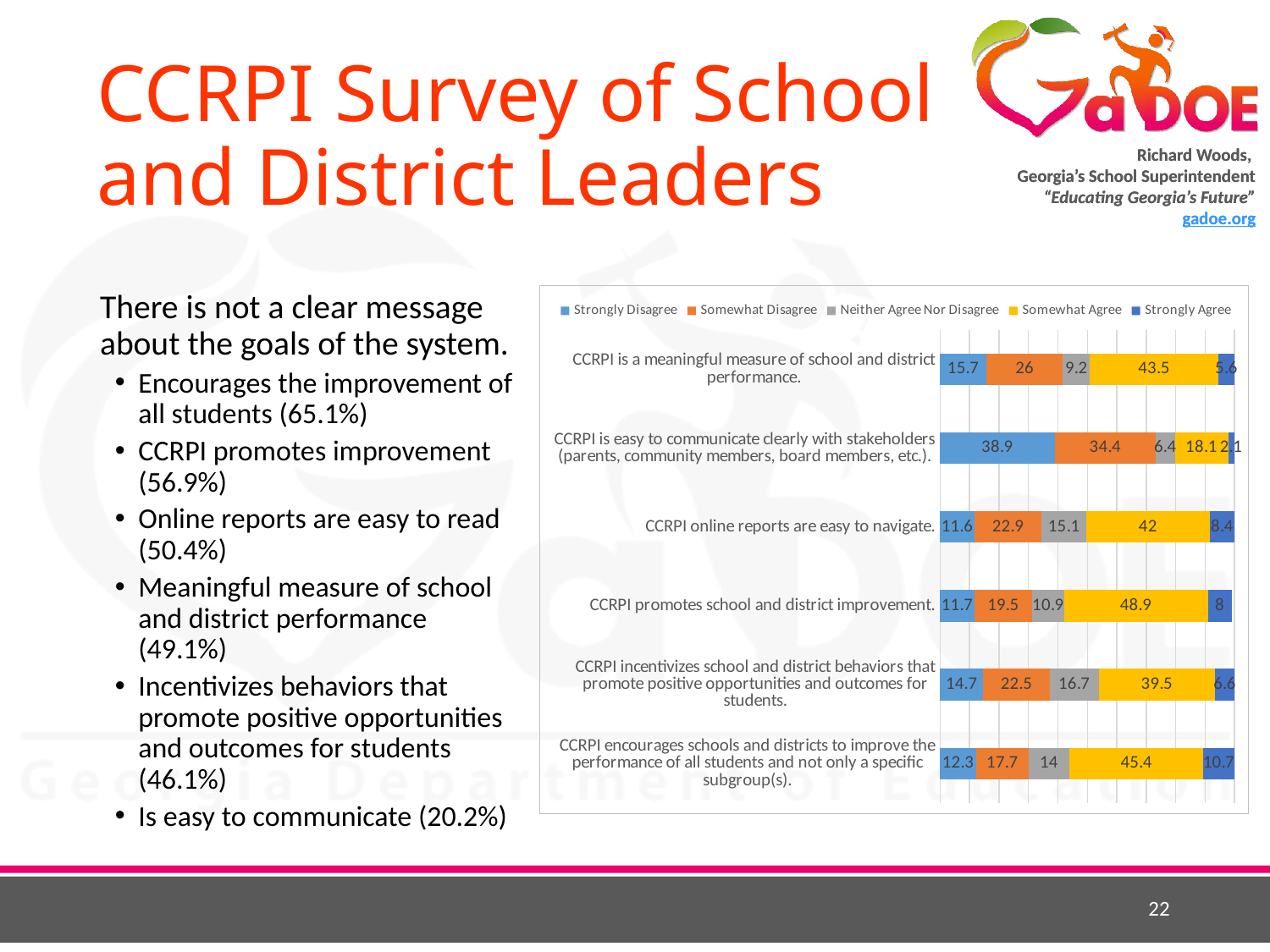
Which statement has the lowest Somewhat Agree value? CCRPI is easy to communicate clearly with stakeholders (parents, community members, board members, etc.). What is the Neither Agree Nor Disagree value for "CCRPI incentivizes school and district behaviors that promote positive opportunities and outcomes for students"? 16.7 What type of chart is shown on the slide? Stacked bar chart Which statement has the highest Somewhat Agree value? CCRPI promotes school and district improvement. What is the total of the stacked bar for "CCRPI is a meaningful measure of school and district performance"? 100 What is the difference between the Strongly Disagree values for "CCRPI is easy to communicate clearly with stakeholders" and "CCRPI is a meaningful measure of school and district performance"? 23.2 How many series does the chart legend list? 5 What percentage of respondents strongly disagree that CCRPI is easy to communicate clearly with stakeholders? 38.9 What is the Somewhat Agree value for "CCRPI promotes school and district improvement"? 48.9 How many statements (categories) are shown in the chart? 6 What is the Strongly Agree value for "CCRPI encourages schools and districts to improve the performance of all students and not only a specific subgroup(s)"? 10.7 Which is larger: the Somewhat Disagree value for "CCRPI online reports are easy to navigate" or for "CCRPI promotes school and district improvement"? CCRPI online reports are easy to navigate.